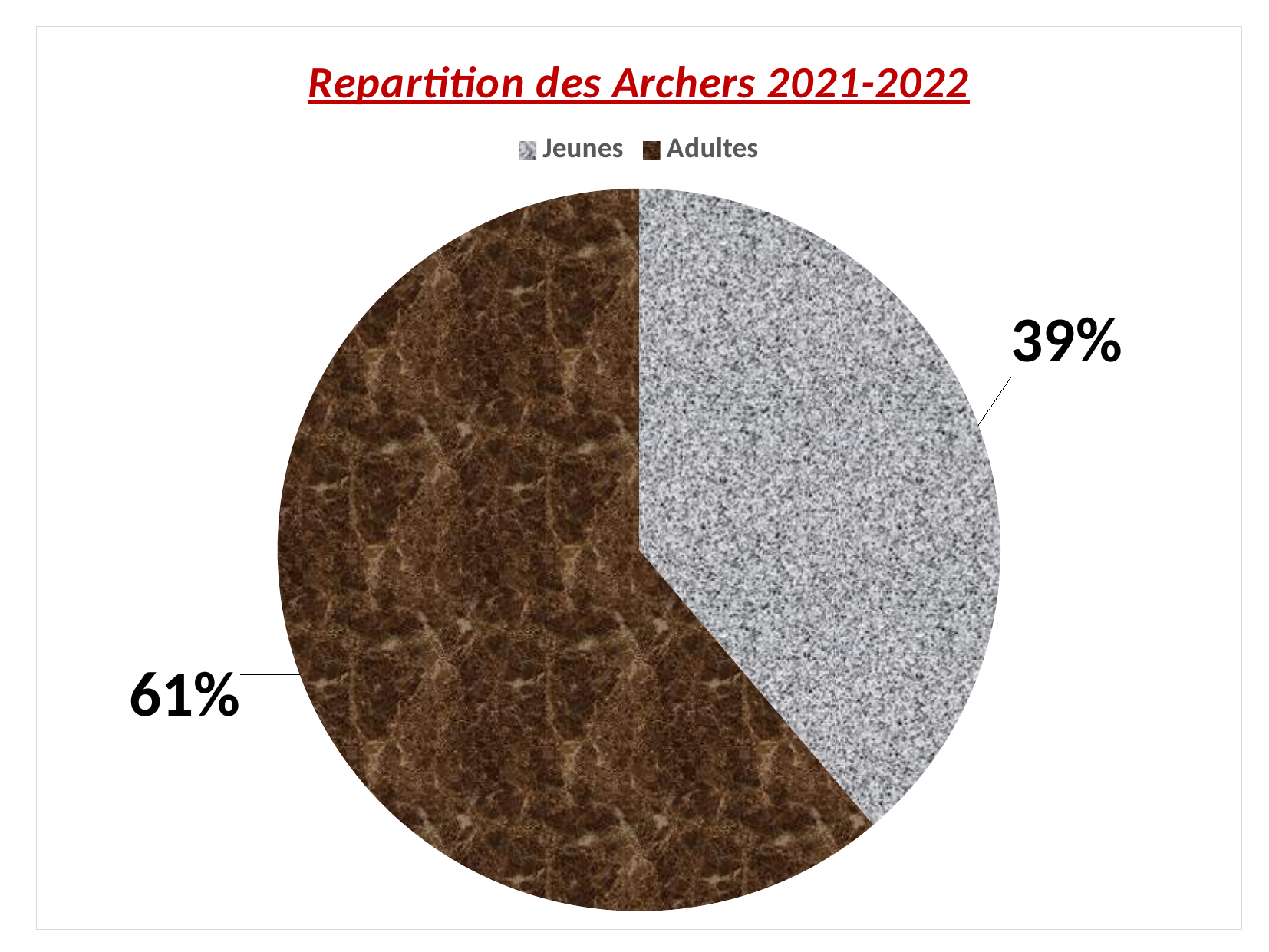
What kind of chart is shown on the slide? pie chart How many entries does the legend list? 2 How many categories does the pie chart have? 2 What share of the pie is Adultes? 61% Which category has the smallest share of the pie? Jeunes Which is larger, the share for Jeunes or the share for Adultes? Adultes What share of the pie is Jeunes? 39% What is the title of the chart? Repartition des Archers 2021-2022 Which category has the largest share of the pie? Adultes Is the share for Jeunes greater or less than 50%? less Which category is shown with the grey speckled fill? Jeunes What is the difference in percentage points between the Adultes share and the Jeunes share? 22